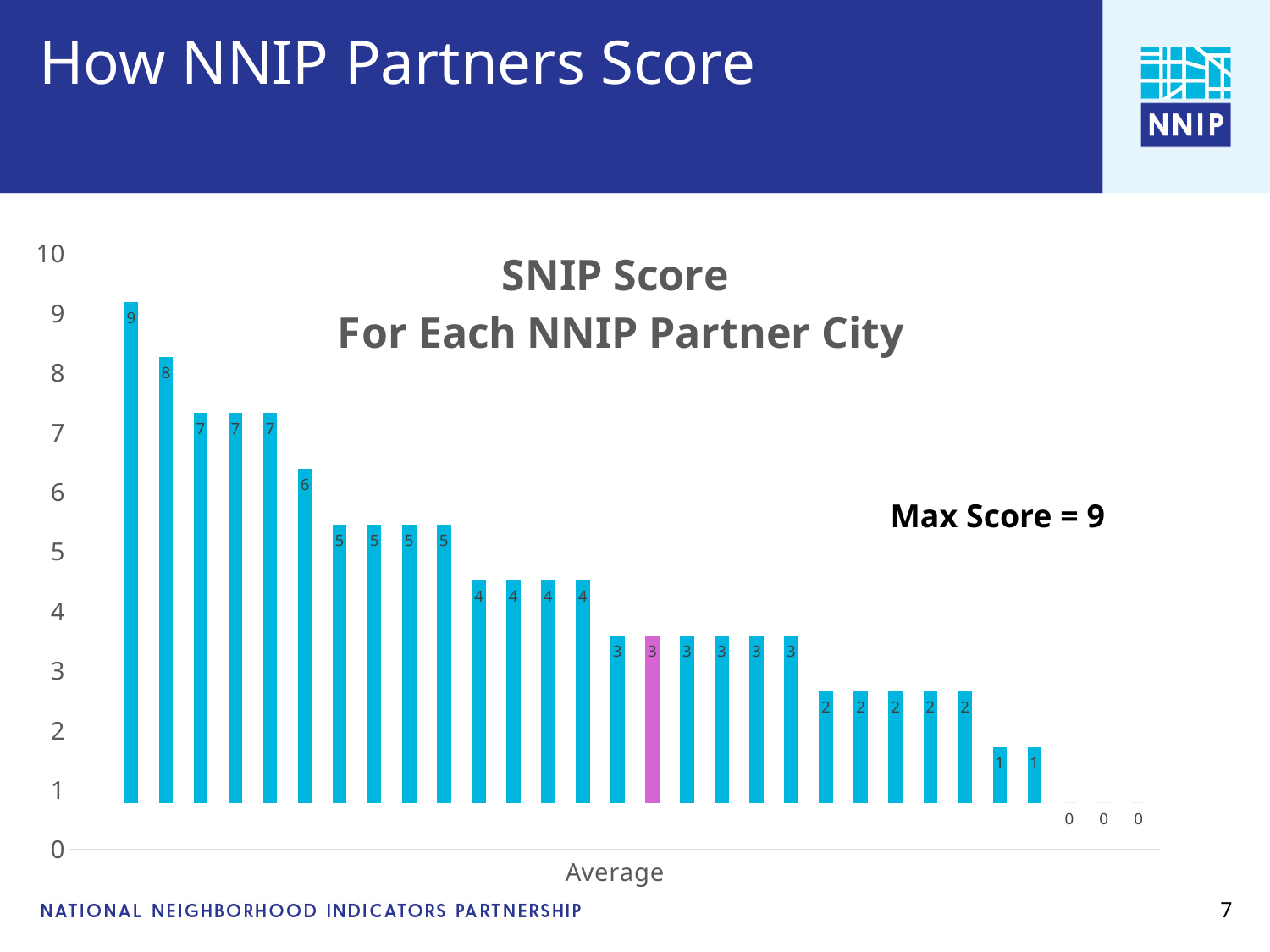
What is the lowest SNIP score shown by any bar in the chart? 0 What is the highest SNIP score shown by any bar in the chart? 9 Do the bar values rise or fall moving from left to right along the x axis? fall What is the difference between the tallest bar (9) and the second tallest bar (8)? 1 What maximum score does the annotation on the chart state? Max Score = 9 Is the value of the tallest bar greater or less than 8? greater How many bars (partner cities) are plotted in the chart? 30 How many bars in the chart have a value of 7? 3 What kind of chart is shown on the slide? bar chart How many bars in the chart have a value of 0? 3 What is the value of the pink (magenta) bar in the chart? 3 What is the title of the chart? SNIP Score For Each NNIP Partner City